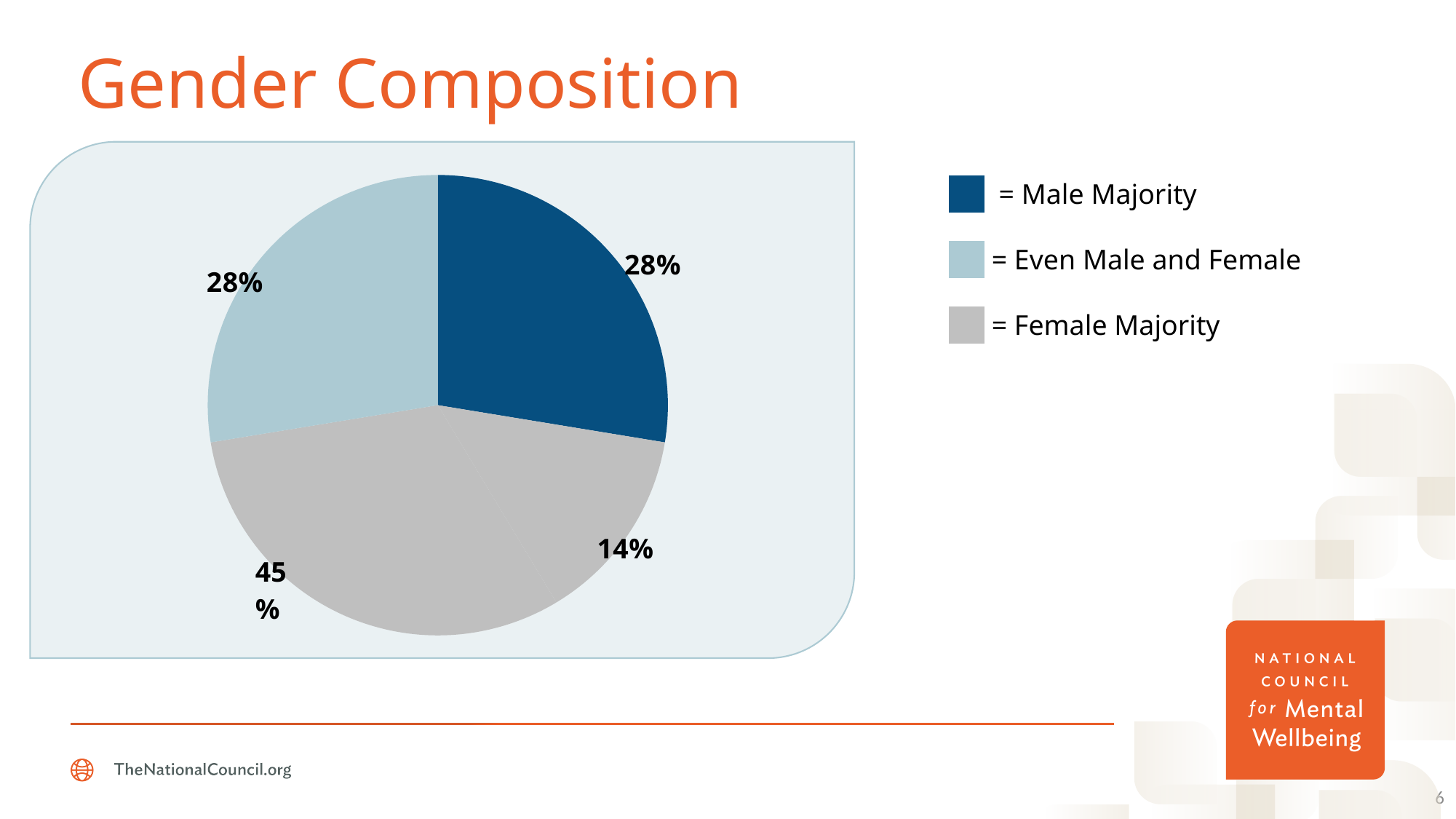
What is the title of the slide containing the pie chart? Gender Composition Which colour represents Male Majority in the pie chart? dark blue How many categories does the legend list? 3 What percentage of the pie is labelled for Male Majority? 28% What percentage of the pie is labelled for Even Male and Female? 28% Is the Female Majority share greater or less than 40%? greater What percentage of the pie is labelled for Female Majority? 45% Which category has the largest slice of the pie? Female Majority Which is larger, the Female Majority slice or the Male Majority slice? Female Majority What type of chart is shown on the slide? pie chart What is the difference between the Female Majority share and the Male Majority share? 17%